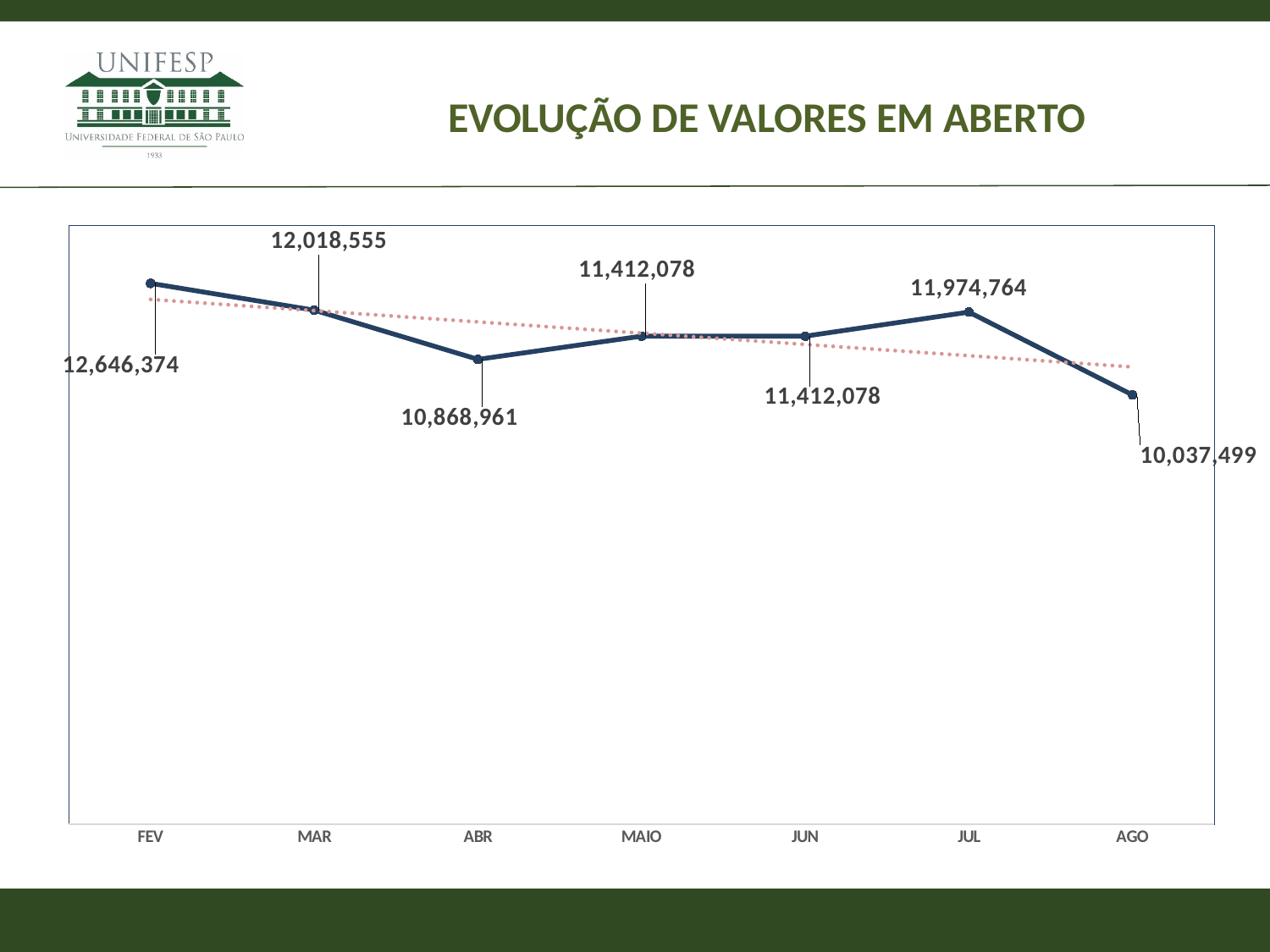
What is the value for FEV? 12,646,374 What is the value for AGO? 10,037,499 Which month has the lowest value? AGO What is the difference between the values for JUL and AGO? 1,937,265 What is the value for JUL? 11,974,764 Which month has the highest value? FEV What kind of chart is shown on the slide? line chart Which is larger, the value for MAR or the value for JUL? MAR How many months are plotted on the x axis? 7 What is the difference between the values for FEV and MAR? 627,819 What is the title of the chart? EVOLUÇÃO DE VALORES EM ABERTO What is the value for ABR? 10,868,961